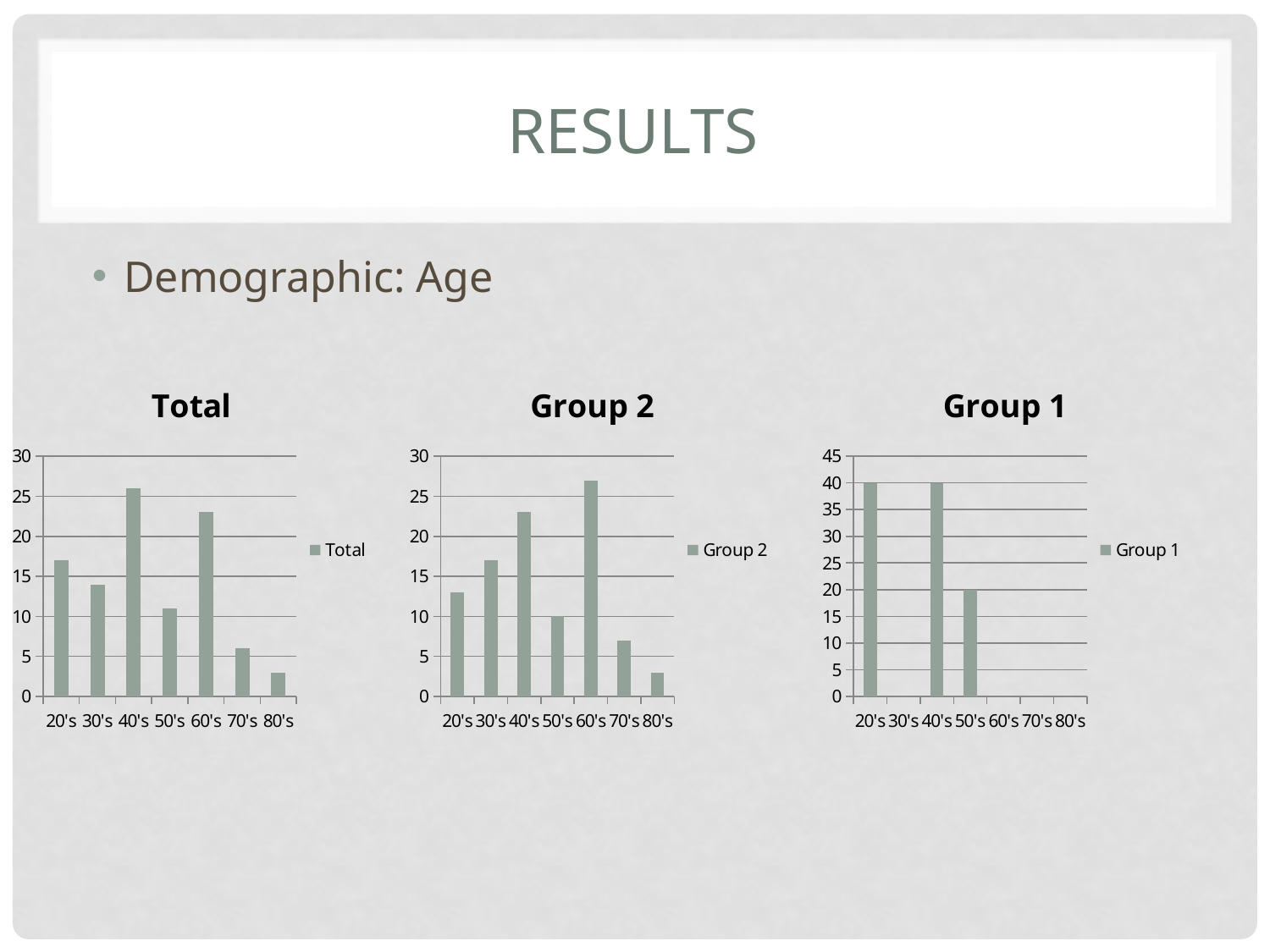
In the Group 2 chart, which age category has the highest value? 60's In the Group 2 chart, is the value for 40's greater or less than 20? greater In the Group 2 chart, what is the value for 50's? 10 In the Total chart, which age category has the lowest value? 80's In the Group 1 chart, what is the value for 50's? 20 In the Group 1 chart, how many age categories are shown on the x axis? 7 What kind of chart is the Total chart? bar chart In the Group 2 chart, which is larger, the value for 20's or the value for 30's? 30's In the Total chart, which age category has the highest value? 40's In the Total chart, is the value for 70's greater or less than 10? less In the Total chart, is the value for 20's greater or less than 15? greater In the Group 1 chart, what is the value for 20's? 40